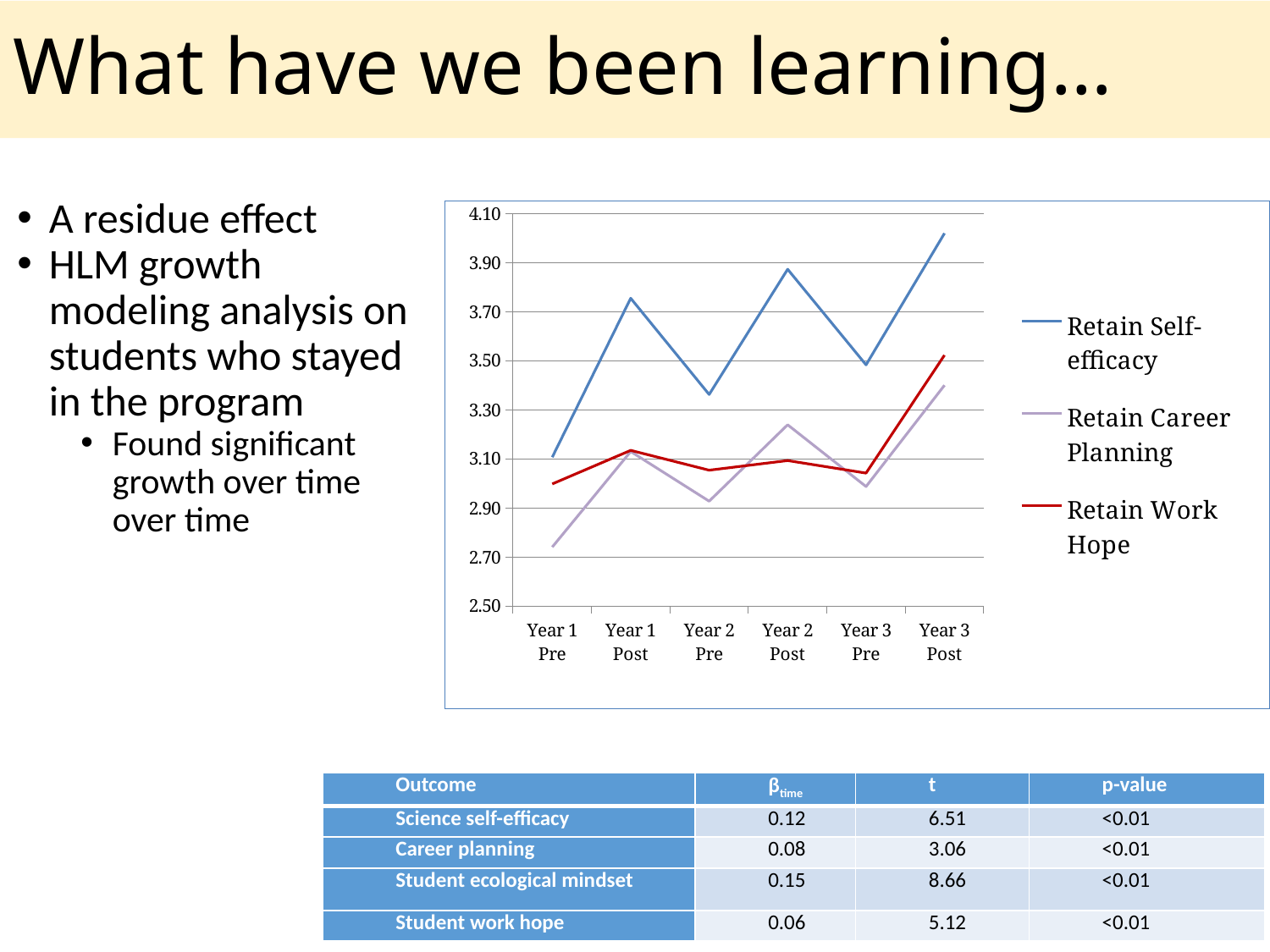
At Year 1 Pre, which is larger: Retain Self-efficacy or Retain Work Hope? Retain Self-efficacy At which time point does the Retain Self-efficacy line reach its highest value? Year 3 Post Is the value for Retain Career Planning at Year 1 Pre greater or less than 2.90? less Is the value for Retain Self-efficacy at Year 1 Pre greater or less than 3.30? less At which time point does the Retain Career Planning line reach its lowest value? Year 1 Pre Which series has the highest values across the chart? Retain Self-efficacy How many series does the chart's legend list? 3 How many time points are shown along the x axis of the chart? 6 What kind of chart is shown on the slide? line chart Does the Retain Self-efficacy line rise or fall from Year 3 Pre to Year 3 Post? rise What colour is the Retain Work Hope line in the chart? red Is the value for Retain Self-efficacy at Year 3 Post greater or less than 3.90? greater